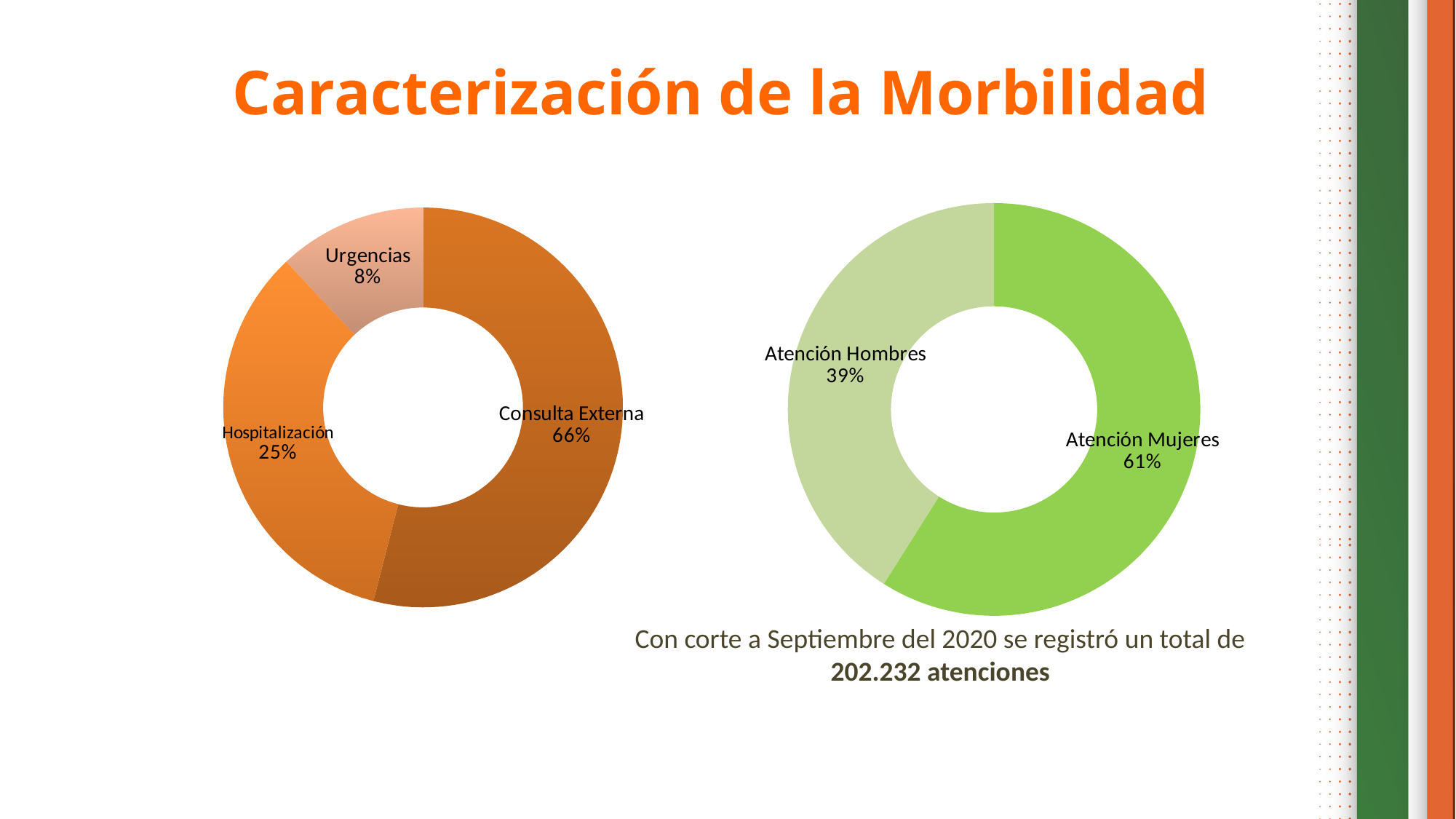
In the left (orange) doughnut chart, what is the difference in percentage points between Consulta Externa and Hospitalización? 41 In the right (green) doughnut chart, which is larger, Atención Hombres or Atención Mujeres? Atención Mujeres In the left (orange) doughnut chart, what share is labelled for Urgencias? 8% What kind of chart is the left (orange) chart on the slide? Doughnut (pie) chart In the left (orange) doughnut chart, what share is labelled for Hospitalización? 25% In the left (orange) doughnut chart, how many categories are shown? 3 In the left (orange) doughnut chart, what share is labelled for Consulta Externa? 66% In the left (orange) doughnut chart, which category has the smallest share? Urgencias In the left (orange) doughnut chart, which category has the largest share? Consulta Externa In the right (green) doughnut chart, what share is labelled for Atención Mujeres? 61% In the right (green) doughnut chart, what is the difference in percentage points between Atención Mujeres and Atención Hombres? 22 In the right (green) doughnut chart, what share is labelled for Atención Hombres? 39%